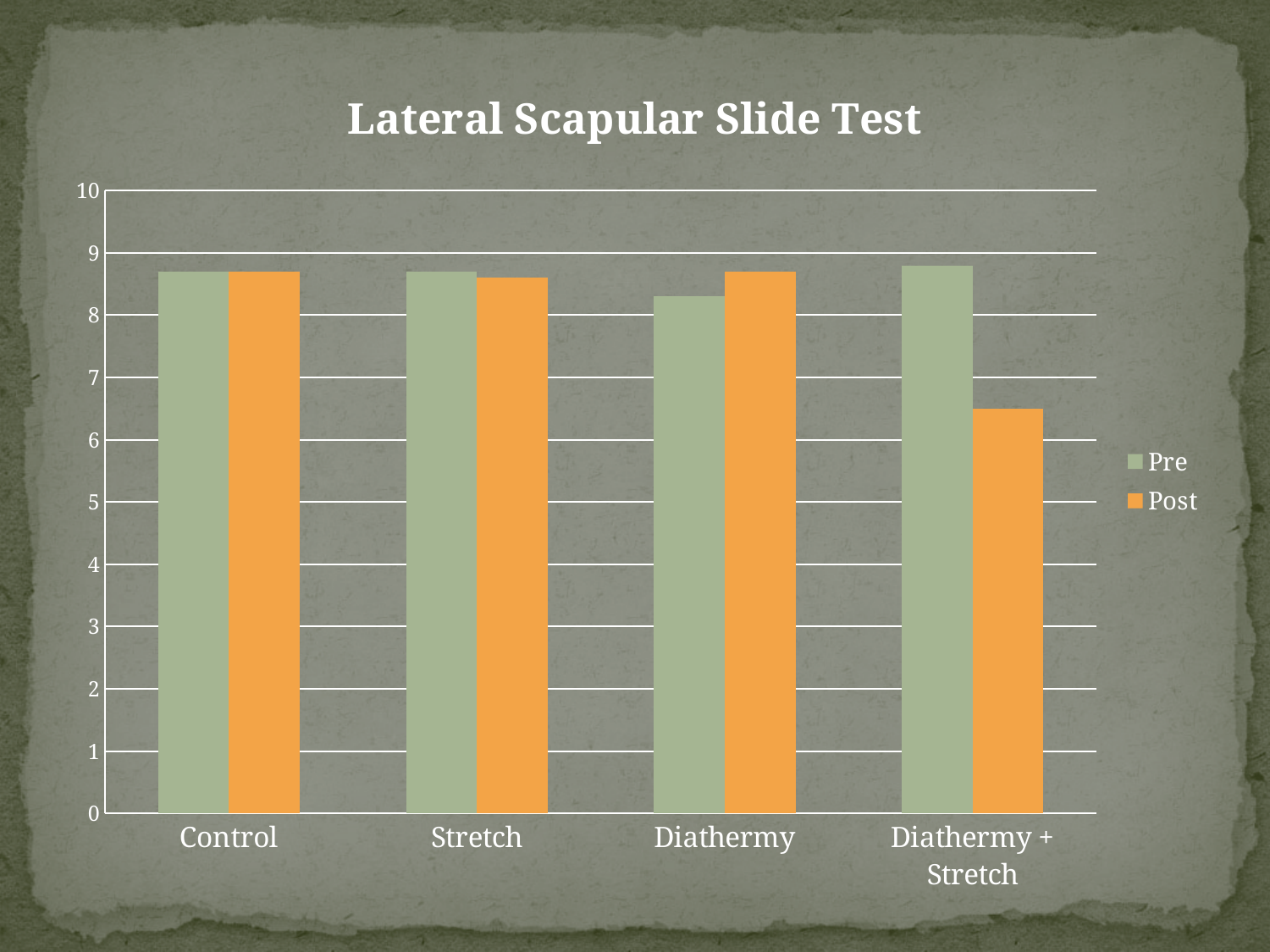
Is the Post value for Diathermy + Stretch greater or less than 7? less For Diathermy, is the Pre value or the Post value larger? Post How many series does the legend list? 2 Is the Post value for Stretch greater or less than 9? less Which category has the lowest Pre value? Diathermy What are the two series named in the legend? Pre and Post What is the title of the chart? Lateral Scapular Slide Test What kind of chart is shown on the slide? bar chart Which category has the lowest Post value? Diathermy + Stretch For Diathermy + Stretch, is the Pre value or the Post value larger? Pre How many categories are shown on the x axis? 4 Is the Pre value for Control greater or less than 8? greater